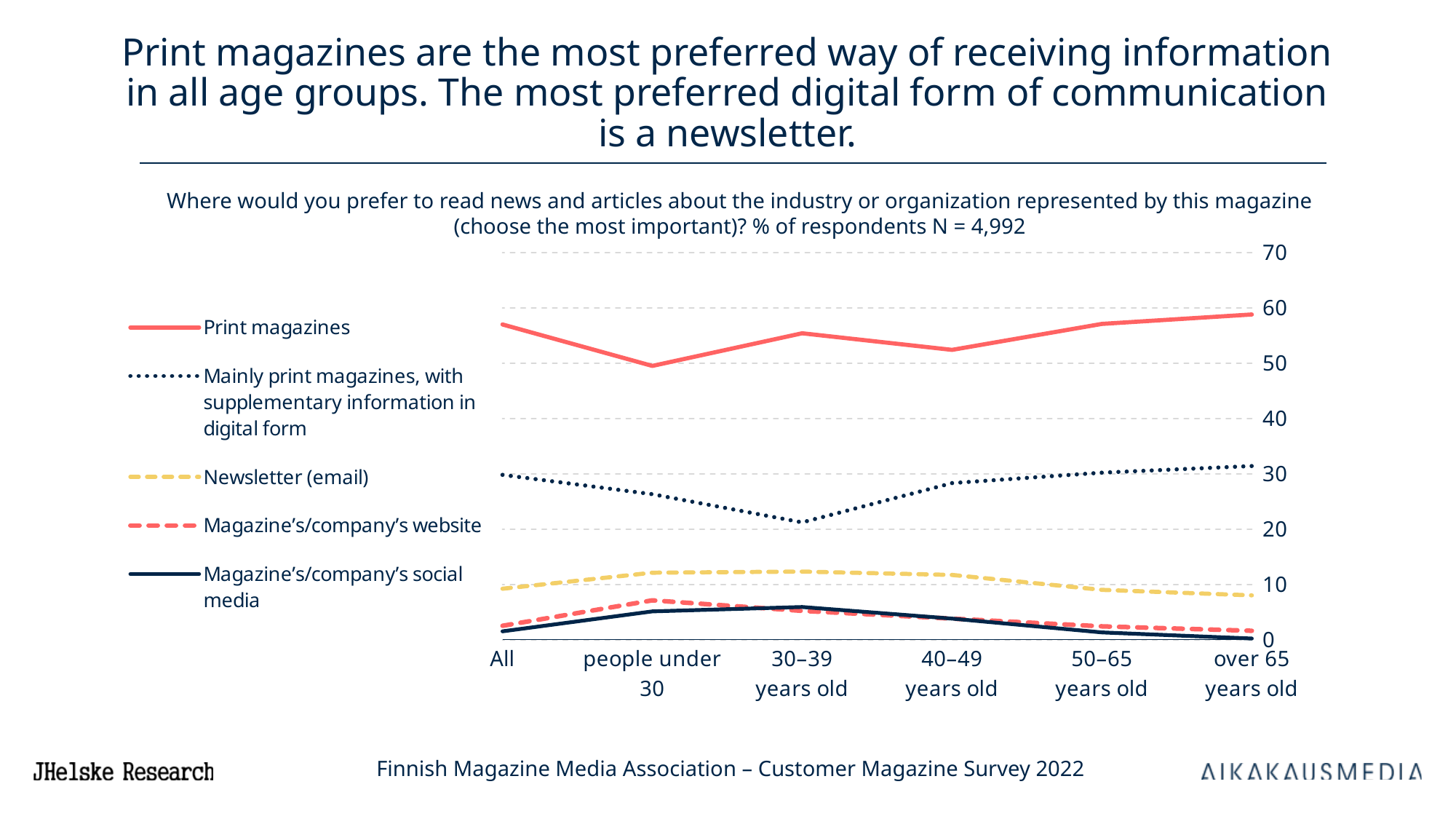
Is the value for 'Mainly print magazines, with supplementary information in digital form' for 30–39 years old greater or less than 30? less Which series has the highest values across all age groups? Print magazines In the All category, which is larger: Newsletter (email) or Magazine's/company's website? Newsletter (email) How many categories are shown along the x axis? 6 Which series is drawn as a solid red line? Print magazines How many series does the legend list? 5 What kind of chart is shown on the slide? line chart Is the value for Magazine's/company's social media for over 65 years old greater or less than 10? less Is the value for Print magazines in the All category greater or less than 50? greater For the Print magazines series, which category has the lowest value? people under 30 Does the 'Mainly print magazines, with supplementary information in digital form' series rise or fall from 30–39 years old to over 65 years old? rise For the 'Mainly print magazines, with supplementary information in digital form' series, which category has the lowest value? 30–39 years old